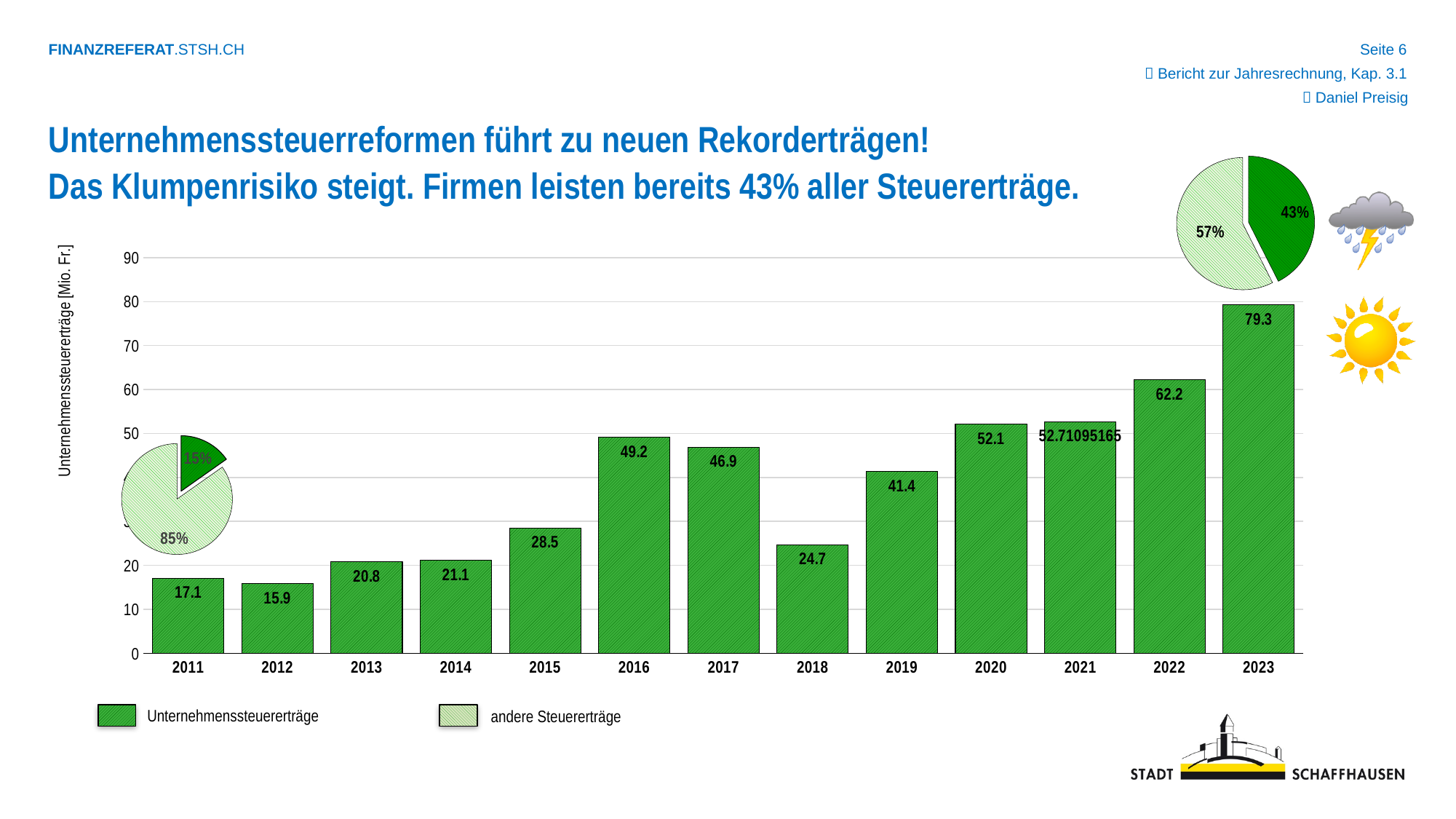
In the bar chart, which year has the highest value? 2023 In the bar chart, what is the difference between the values for 2023 and 2022? 17.1 In the bar chart, which year has the lowest value? 2012 In the bar chart, is the value for 2019 greater or less than 40? greater In the pie chart at the top right, what share is labelled for the dark green slice? 43% In the bar chart, which is larger, the value for 2016 or the value for 2017? 2016 What kind of chart is the large chart showing values by year? bar chart How many years are shown on the x axis of the bar chart? 13 In the bar chart, what is the value for 2012? 15.9 In the bar chart, what is the value for 2016? 49.2 In the bar chart, what is the value for 2023? 79.3 How many entries does the legend below the bar chart list? 2